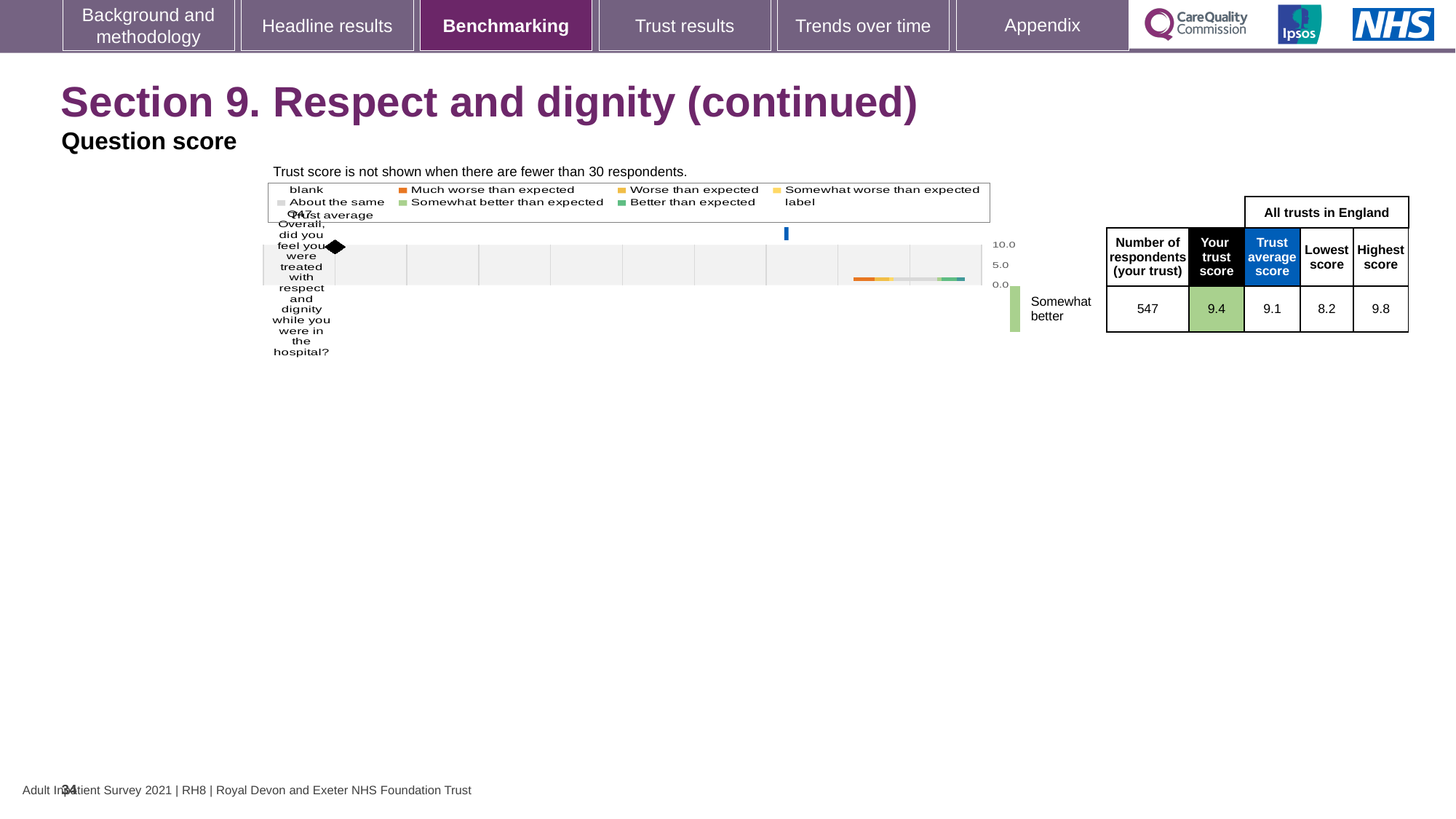
What is the difference between the highest score and the lowest score for all trusts in England? 1.6 What is the 'Your trust score' value shown for the respect and dignity question? 9.4 What is the 'Trust average score' shown for the respect and dignity question? 9.1 What is the 'Highest score' shown for all trusts in England? 9.8 Which is larger, your trust score or the trust average score? Your trust score What is the highest tick value shown on the chart's value axis? 10.0 What colour does the legend use for 'Much worse than expected'? orange How many question categories are plotted on the chart? 1 How many respondents from your trust are shown for this question? 547 What is the 'Lowest score' shown for all trusts in England? 8.2 What benchmark category label is shown next to the green bar beside the chart? Somewhat better What kind of chart is shown on the slide? bar chart